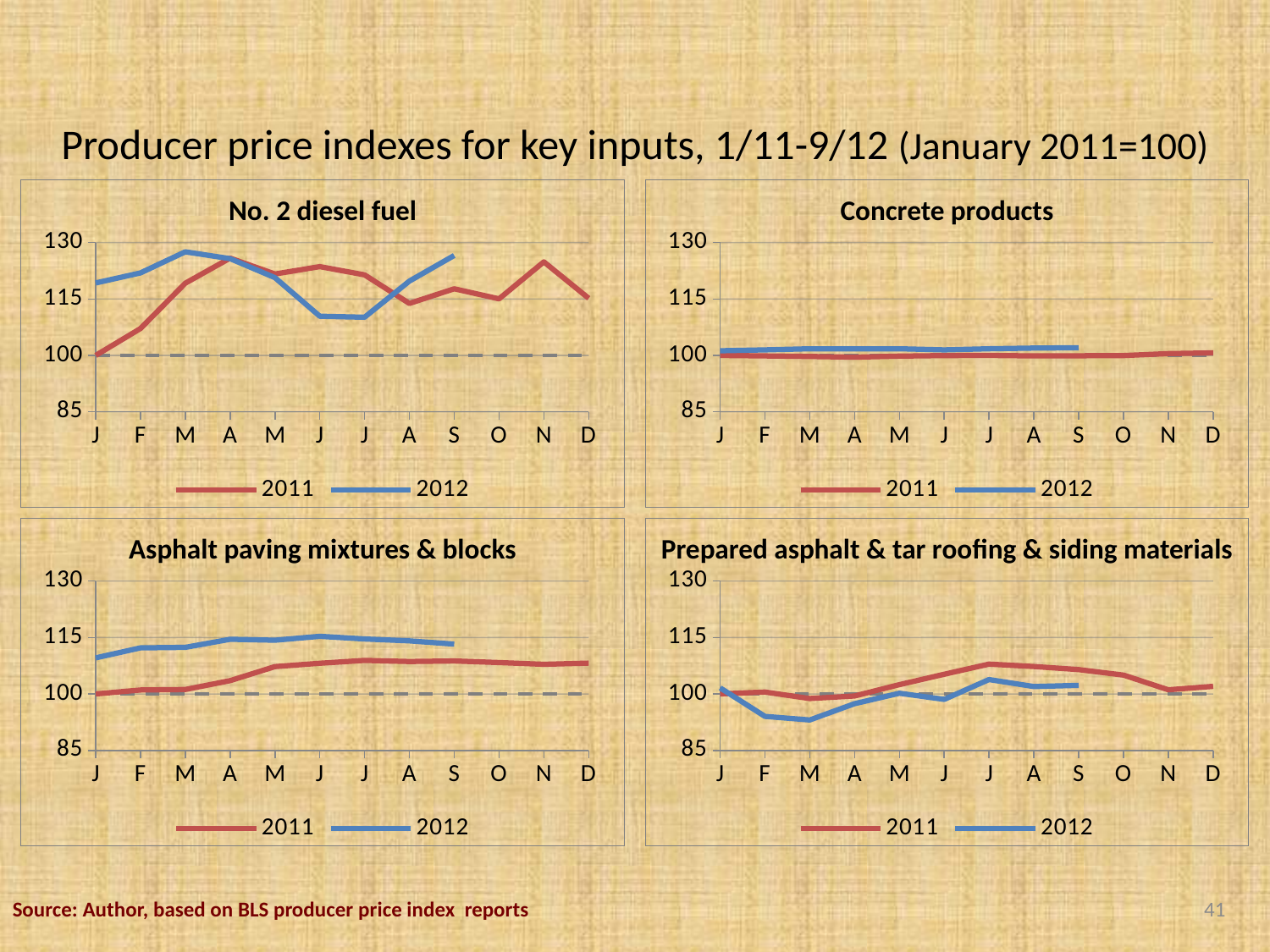
In the "Prepared asphalt & tar roofing & siding materials" chart, is the value for 2012 in M (March) greater or less than 100? less In the "No. 2 diesel fuel" chart, does the 2011 line rise or fall from J (January) to A (April)? Rise In the "Asphalt paving mixtures & blocks" chart, is the value for 2012 in J (January) greater or less than 100? greater In the "Concrete products" chart, what colour is the 2012 line? Blue In the "Asphalt paving mixtures & blocks" chart, how many months are shown on the x axis? 12 In the "Concrete products" chart, is the value for 2011 in D (December) greater or less than 115? less In the "Asphalt paving mixtures & blocks" chart, which series has the higher value in M (May), 2011 or 2012? 2012 In the "No. 2 diesel fuel" chart, what is the value for 2011 in J (January)? 100 What is the title of the bottom-right chart? Prepared asphalt & tar roofing & siding materials What kind of chart is the "No. 2 diesel fuel" chart? Line chart In the "Concrete products" chart, how many series does the legend list? 2